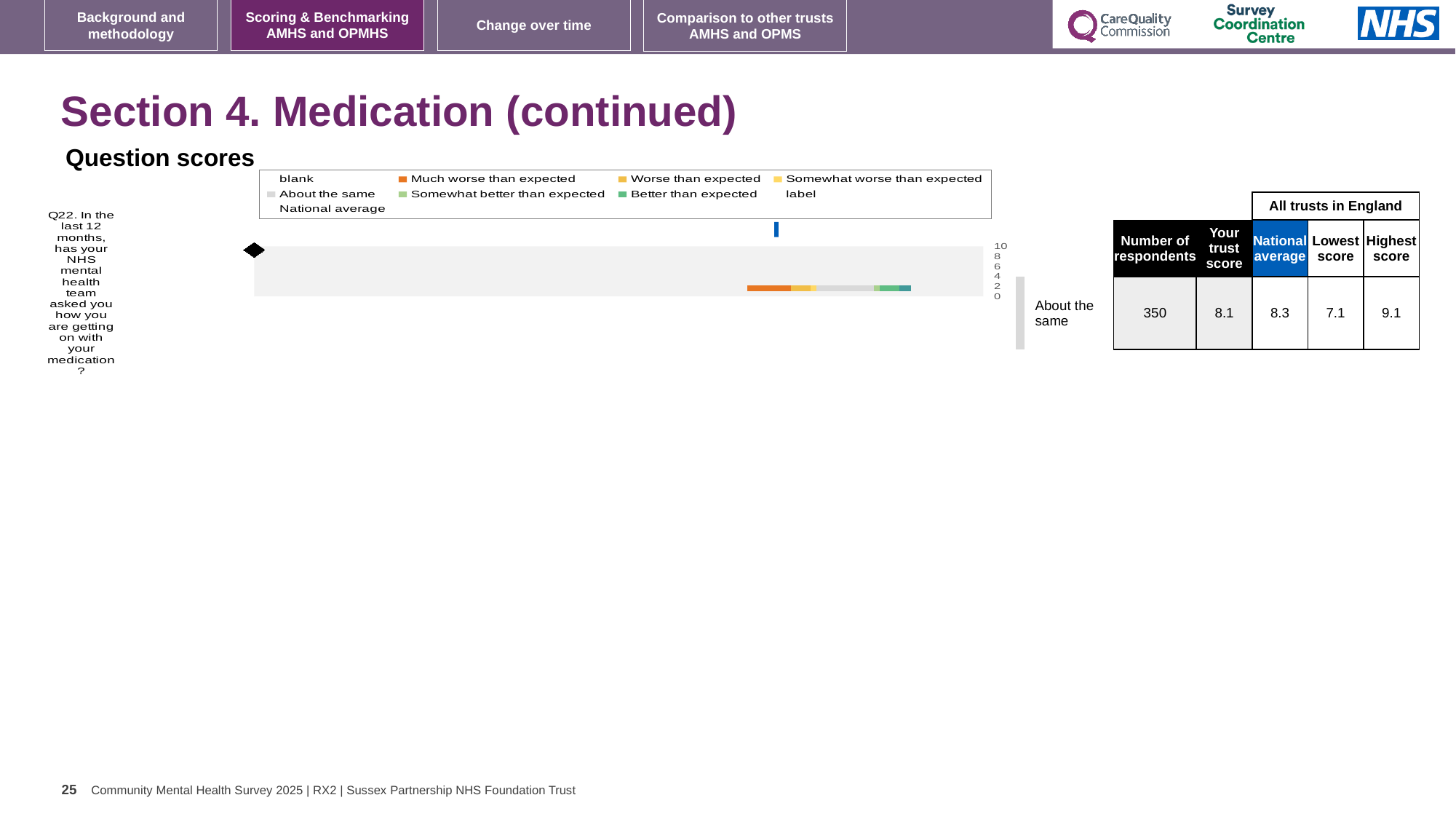
Which is larger for Q22: the trust score or the national average? national average What is the highest score among all trusts in England for Q22? 9.1 What is the national average for Q22 shown on the slide? 8.3 What kind of chart is shown under 'Question scores'? bar chart What is the difference between the highest score and the lowest score for Q22? 2.0 Which legend entry is shown in orange in the Question scores chart? Much worse than expected What is the highest value shown on the chart's numeric axis? 10 How many respondents answered Q22? 350 How is the trust's Q22 result categorised relative to expectation? About the same How many questions (categories) are plotted in the Question scores chart? 1 What is the trust score for Q22 shown on the slide? 8.1 What is the lowest score among all trusts in England for Q22? 7.1